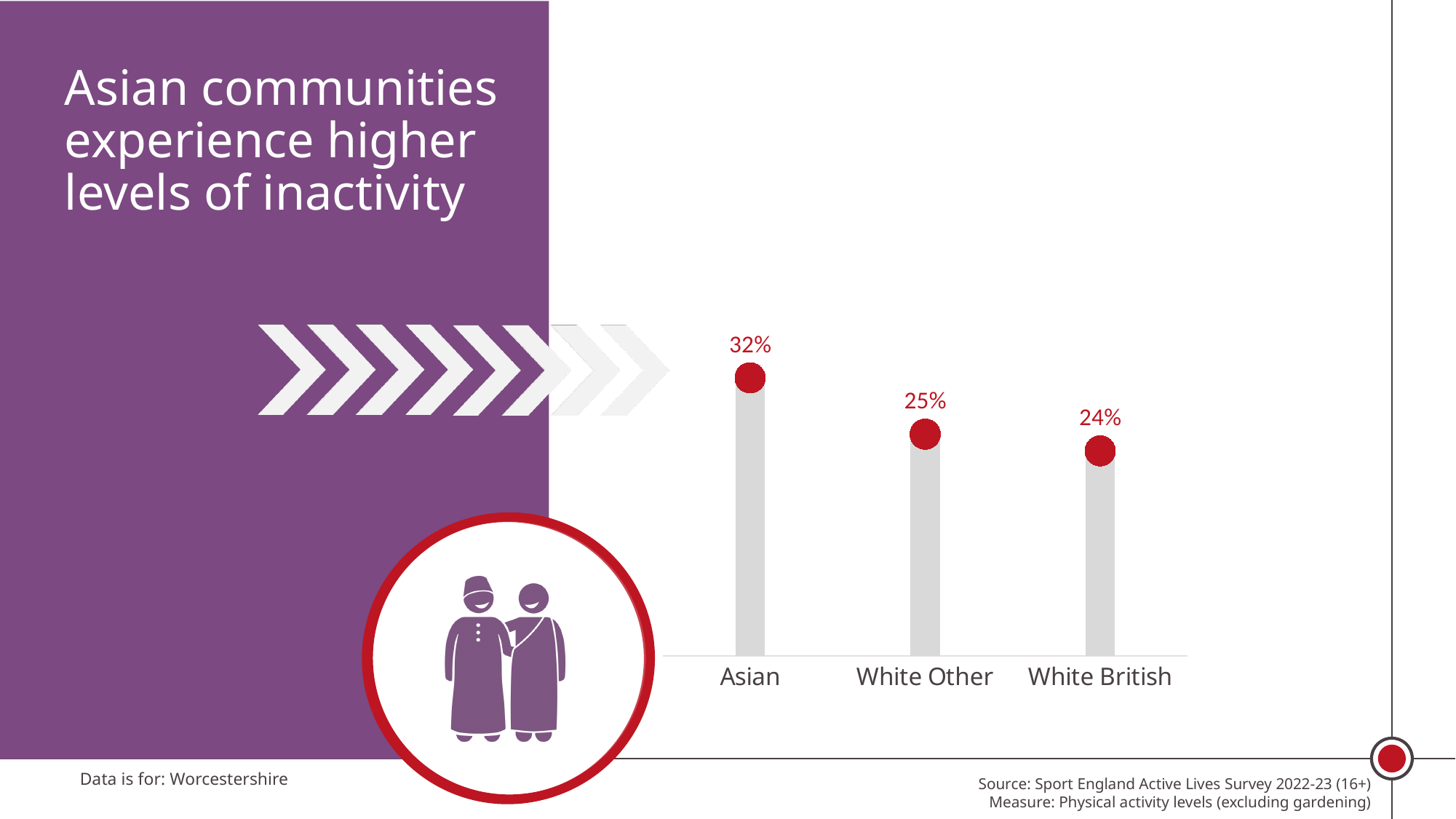
How many categories are shown in the chart? 3 Do the values rise or fall from left to right across the categories? Fall What colour are the markers at the top of each bar? Red What is the value for White Other? 25% What is the value for White British? 24% What kind of chart is shown on the slide? Bar chart Which category has the highest value? Asian What is the value for Asian? 32% Which is larger, the value for Asian or the value for White Other? Asian Which category has the lowest value? White British What is the difference between the values for Asian and White British? 8% What is the difference between the values for Asian and White Other? 7%